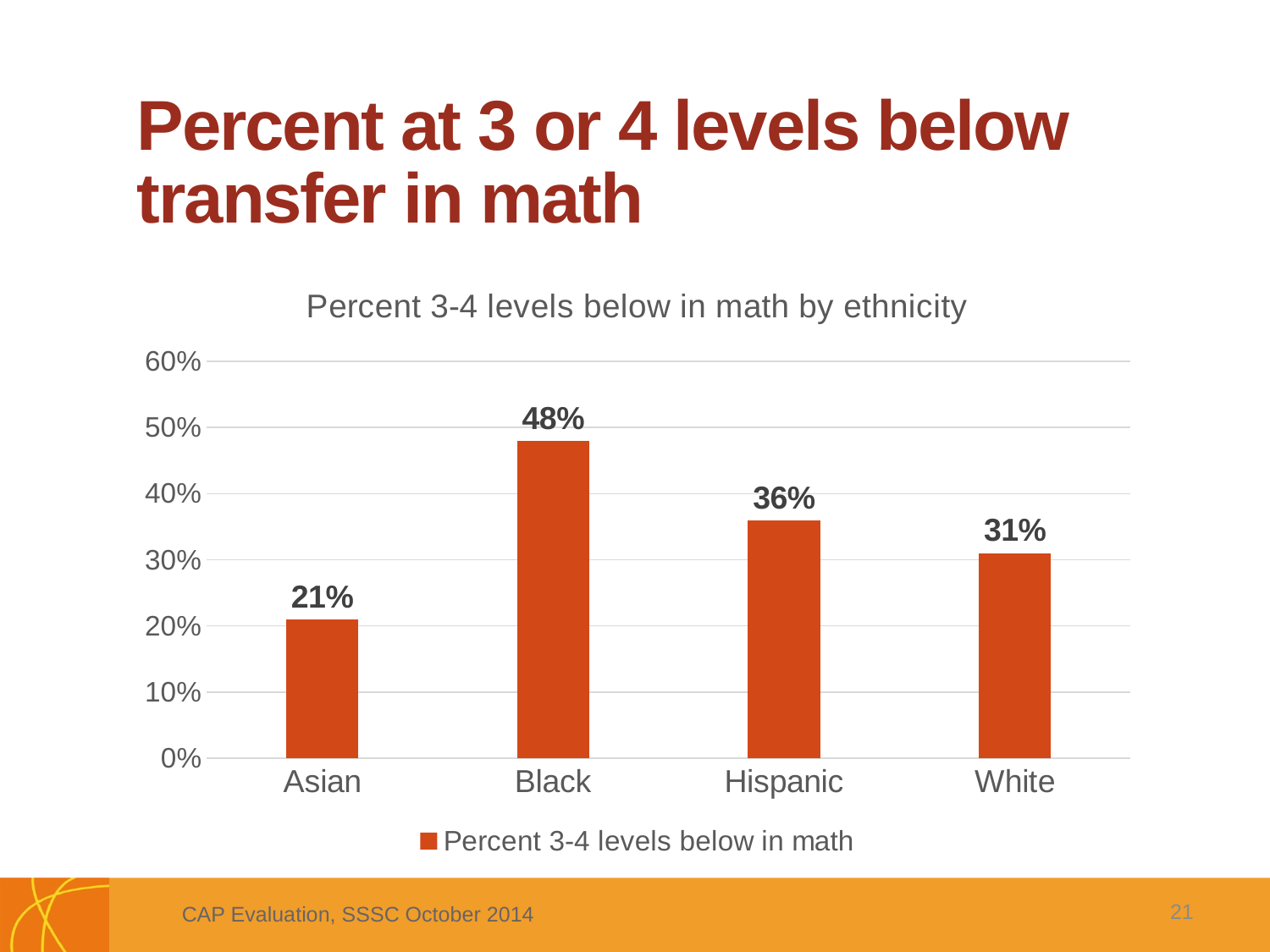
Which ethnicity has the lowest percent 3-4 levels below in math? Asian Which is larger, the value for Hispanic or the value for White? Hispanic What is the value for Asian? 21% Is the value for Black greater or less than 40%? greater What is the title of the chart? Percent 3-4 levels below in math by ethnicity What is the difference between the values for White and Asian? 10% What is the value for Black? 48% What is the value for White? 31% What kind of chart is shown on the slide? bar chart What is the difference between the values for Black and Hispanic? 12% How many ethnicity categories are shown on the chart? 4 Which ethnicity has the highest percent 3-4 levels below in math? Black